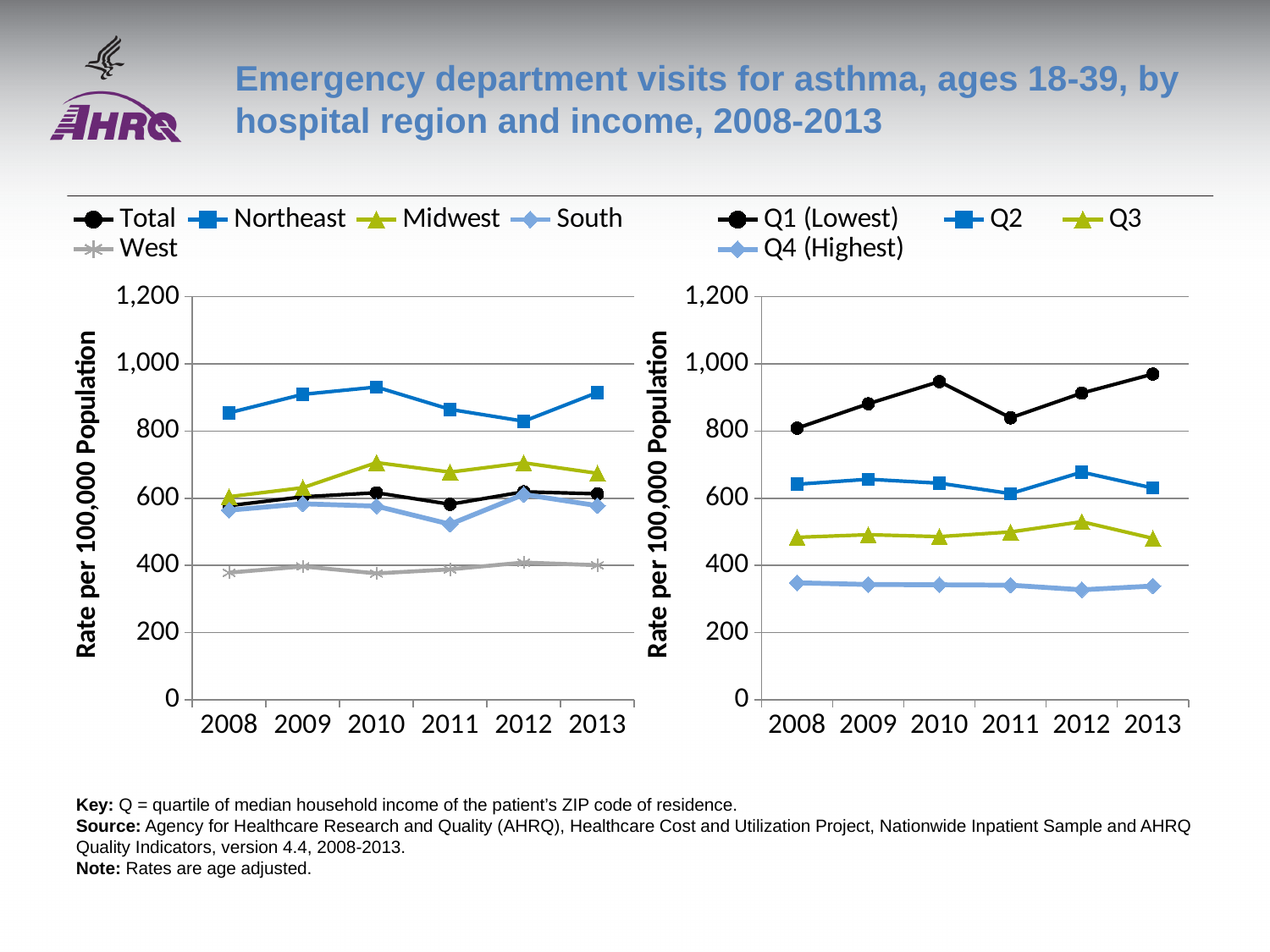
In the right chart, which income quartile has the lowest rate in 2013? Q4 (Highest) In the left chart, which region has the highest rate in 2012? Northeast What kind of chart is the left chart on the slide? line chart In the left chart, is the value for West in 2008 greater or less than 400? less In the left chart, is the value for Northeast in 2010 greater or less than 800? greater In the right chart, which income quartile has the highest rate in 2013? Q1 (Lowest) How many series does the legend of the right chart (by income quartile) list? 4 In the right chart, is the value for Q3 in 2012 greater or less than 600? less What is the y-axis label of the right chart? Rate per 100,000 Population How many years are shown on the x axis of the right chart? 6 How many series does the legend of the left chart (by hospital region) list? 5 In the left chart, which is larger in 2011, Midwest or South? Midwest